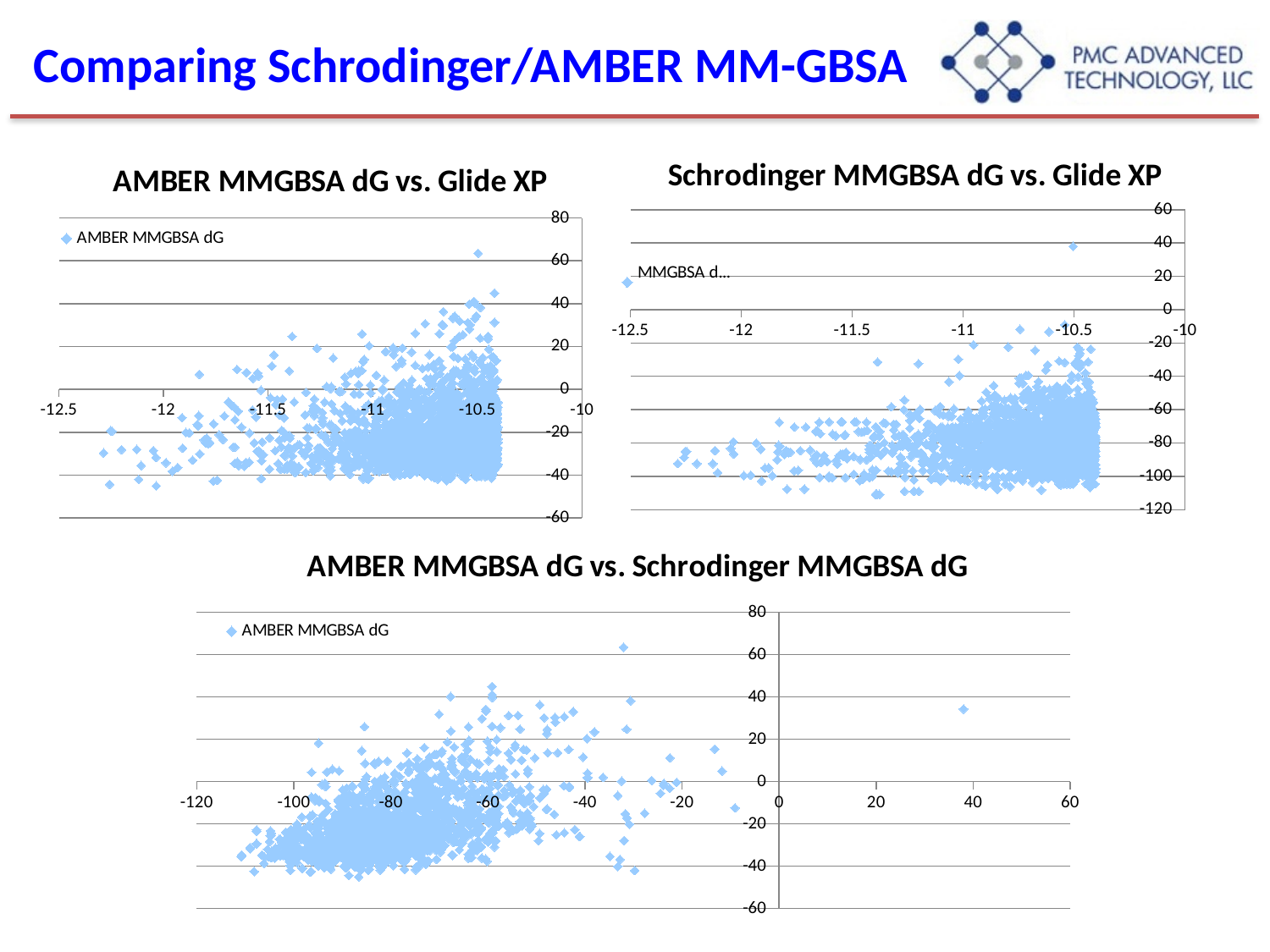
What kind of chart is 'Schrodinger MMGBSA dG vs. Glide XP'? scatter chart What kind of chart is 'AMBER MMGBSA dG vs. Glide XP'? scatter chart What is the title of the chart at the top right of the slide? Schrodinger MMGBSA dG vs. Glide XP In the 'AMBER MMGBSA dG vs. Schrodinger MMGBSA dG' chart, is the y value of the isolated point near x = 40 greater or less than 20? greater In the 'Schrodinger MMGBSA dG vs. Glide XP' chart, is the y value of the isolated point at the far left near x = -12.5 greater or less than 0? greater In the 'AMBER MMGBSA dG vs. Glide XP' chart, how many series does the legend list? 1 In the 'AMBER MMGBSA dG vs. Schrodinger MMGBSA dG' chart, do the plotted values generally rise or fall as x increases? rise In the 'AMBER MMGBSA dG vs. Schrodinger MMGBSA dG' chart, what series name does the legend show? AMBER MMGBSA dG In the 'Schrodinger MMGBSA dG vs. Glide XP' chart, is the y value of the highest point greater or less than 20? greater How many charts are shown on the slide? 3